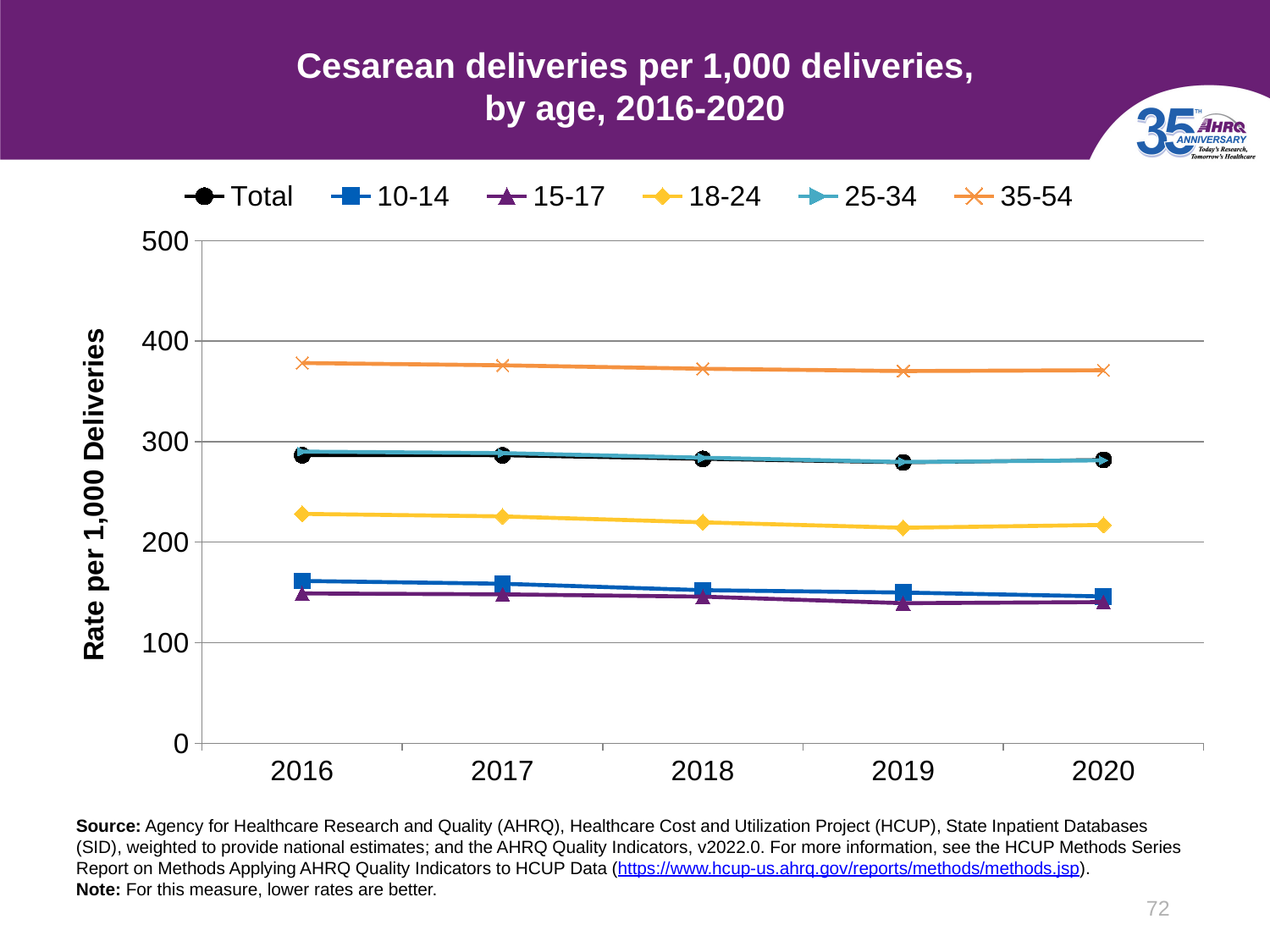
Is the value for the 35-54 age group in 2016 greater or less than 400? less How many years are plotted along the x axis? 5 Which age group has the lowest cesarean delivery rate in 2019? 15-17 How many series does the legend list? 6 What kind of chart is shown on the slide? line chart Is the value for the 18-24 age group in 2016 greater or less than 200? greater Which age group has the highest cesarean delivery rate in 2016? 35-54 In 2018, which is larger: the rate for the 18-24 age group or the 35-54 age group? 35-54 Is the value for the 10-14 age group in 2020 greater or less than 200? less Does the rate for the 35-54 age group rise or fall from 2016 to 2020? fall What is the label on the y axis? Rate per 1,000 Deliveries